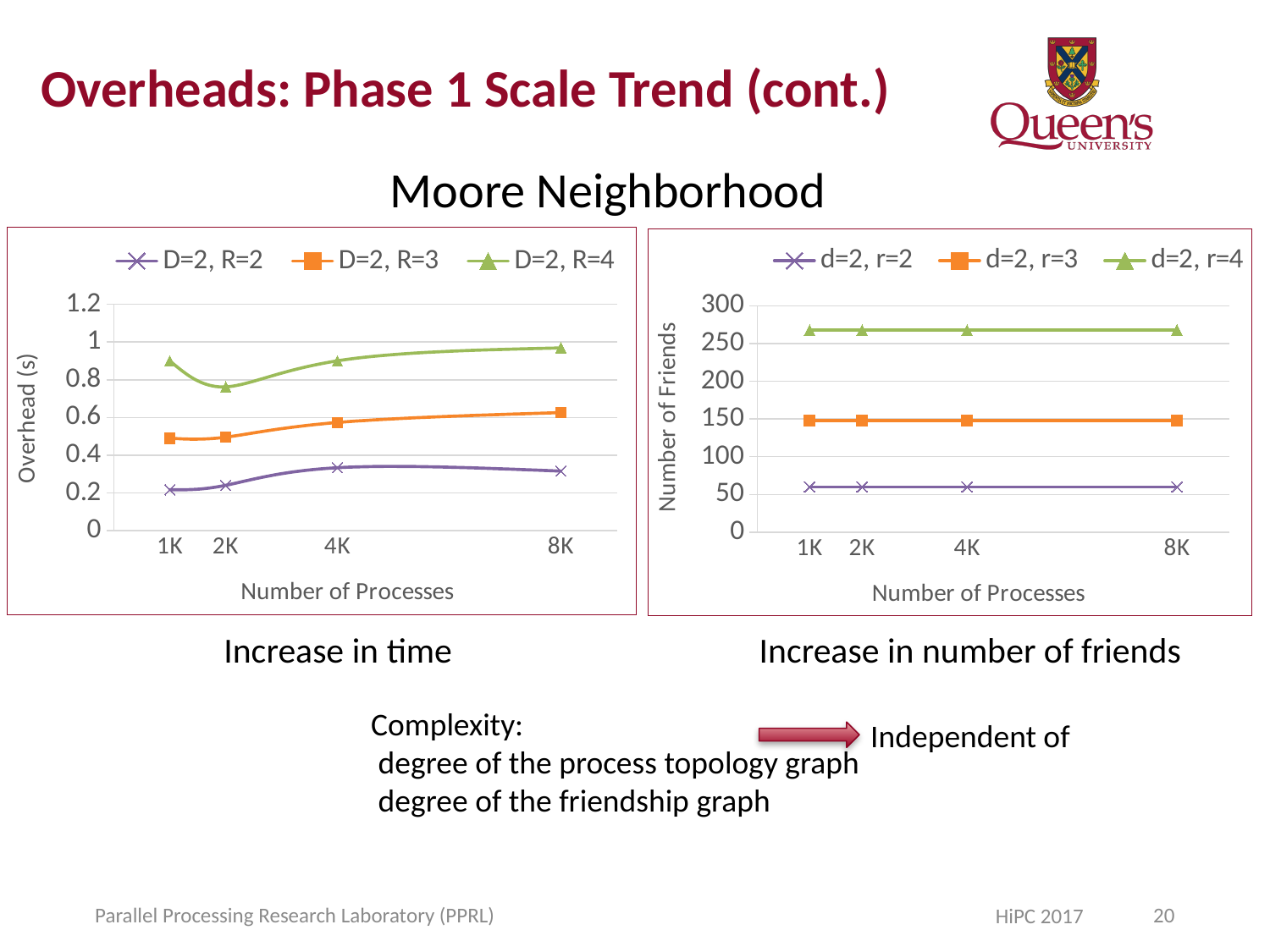
What is the y-axis title of the left chart (Increase in time)? Overhead (s) In the right chart (Increase in number of friends), which series has the lowest number of friends? d=2, r=2 How many series does the legend of the left chart (Increase in time) list? 3 In the left chart (Increase in time), is the value for D=2, R=2 at 1K greater or less than 0.4? less In the right chart (Increase in number of friends), do the values for d=2, r=3 rise, fall, or stay flat as the number of processes increases? stay flat What type of chart is the left chart (Increase in time)? line chart In the right chart (Increase in number of friends), is the value for d=2, r=2 at 8K greater or less than 100? less How many x-axis categories (numbers of processes) are shown on the right chart (Increase in number of friends)? 4 In the right chart (Increase in number of friends), is the value for d=2, r=4 at 4K greater or less than 250? greater In the left chart (Increase in time), which series has the highest overhead at 8K? D=2, R=4 In the left chart (Increase in time), which is larger at 4K: the value for D=2, R=3 or the value for D=2, R=2? D=2, R=3